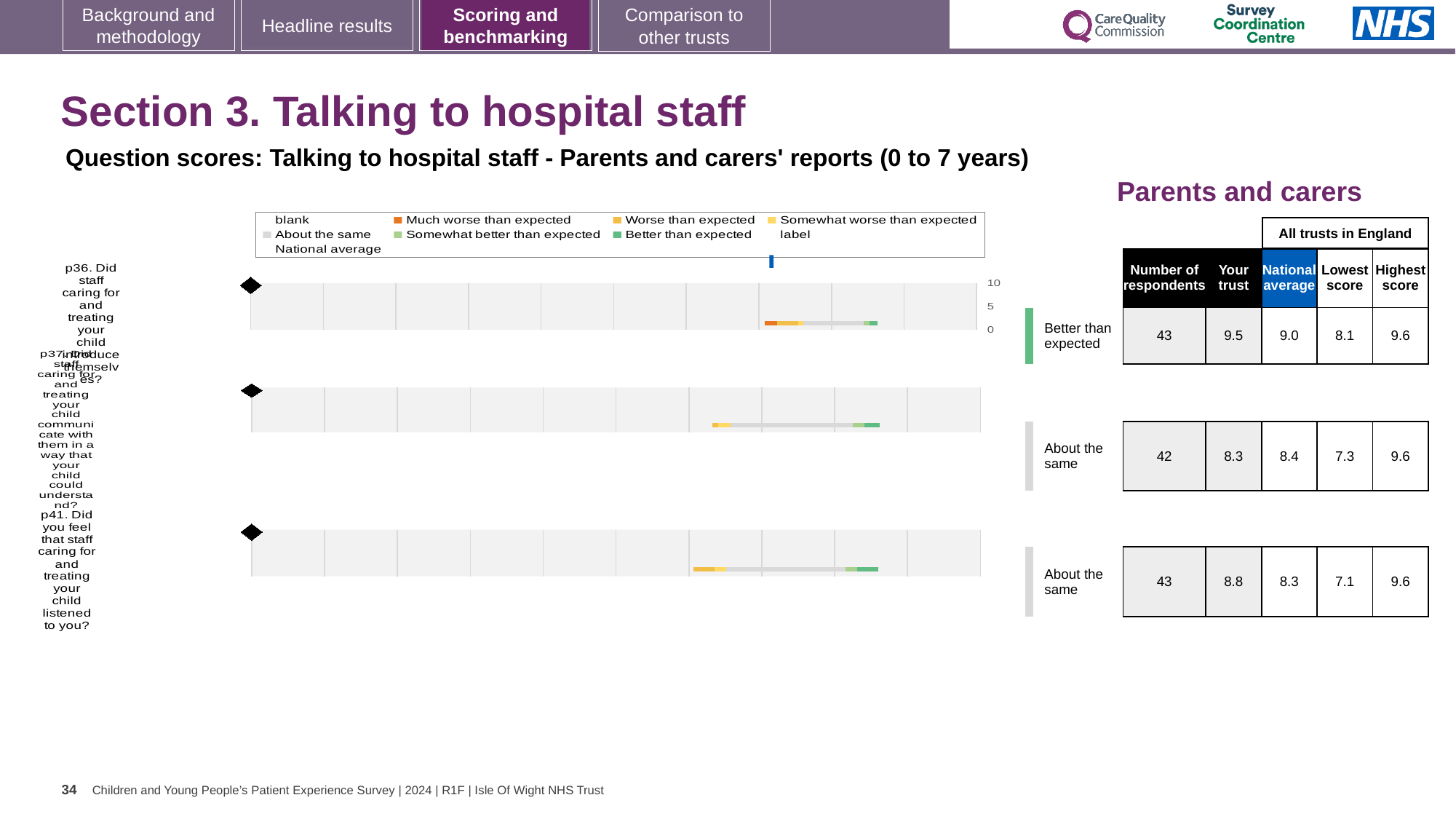
What is the national average score for p37 (Did staff communicate with your child in a way they could understand?)? 8.4 What is the 'Your trust' score for p36 (Did staff caring for and treating your child introduce themselves?)? 9.5 How many questions (p36, p37, p41) are plotted in the chart? 3 Which question has the lowest 'Your trust' score? p37 What is the lowest score among all trusts in England for p37? 7.3 What benchmark category is shown for p36? Better than expected Which question has the highest 'Your trust' score? p36 For p36, what is the difference between the 'Your trust' score and the national average? 0.5 What kind of chart is used to show the question scores on this slide? Bar chart For p41, which is larger: the 'Your trust' score or the national average? Your trust What is the highest score among all trusts in England for p41? 9.6 How many respondents answered p41 (Did you feel that staff listened to you?)? 43